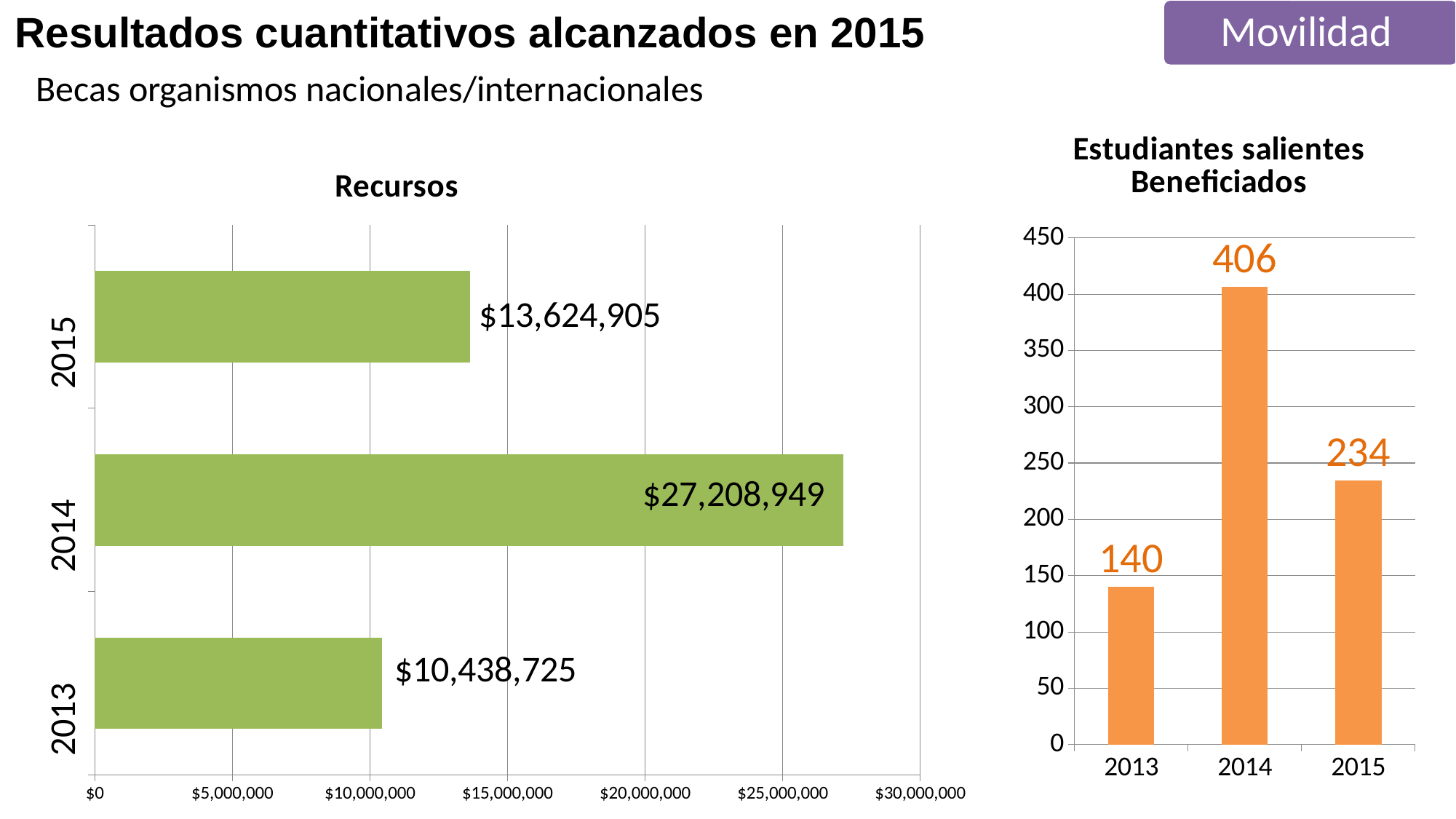
In the 'Recursos' chart, what is the value for 2013? $10,438,725 In the 'Estudiantes salientes Beneficiados' chart, which year has the lowest value? 2013 In the 'Recursos' chart, which year has the lowest value? 2013 In the 'Estudiantes salientes Beneficiados' chart, is the value for 2015 larger than the value for 2014? No In the 'Estudiantes salientes Beneficiados' chart, what is the value for 2014? 406 In the 'Estudiantes salientes Beneficiados' chart, what is the difference between the 2015 and 2013 values? 94 In the 'Recursos' chart, what is the difference between the 2014 and 2015 values? $13,584,044 In the 'Recursos' chart, which year has the highest value? 2014 In the 'Estudiantes salientes Beneficiados' chart, how many years are shown? 3 In the 'Estudiantes salientes Beneficiados' chart, what is the value for 2013? 140 In the 'Recursos' chart, what kind of chart is shown? bar chart In the 'Recursos' chart, what is the value for 2014? $27,208,949